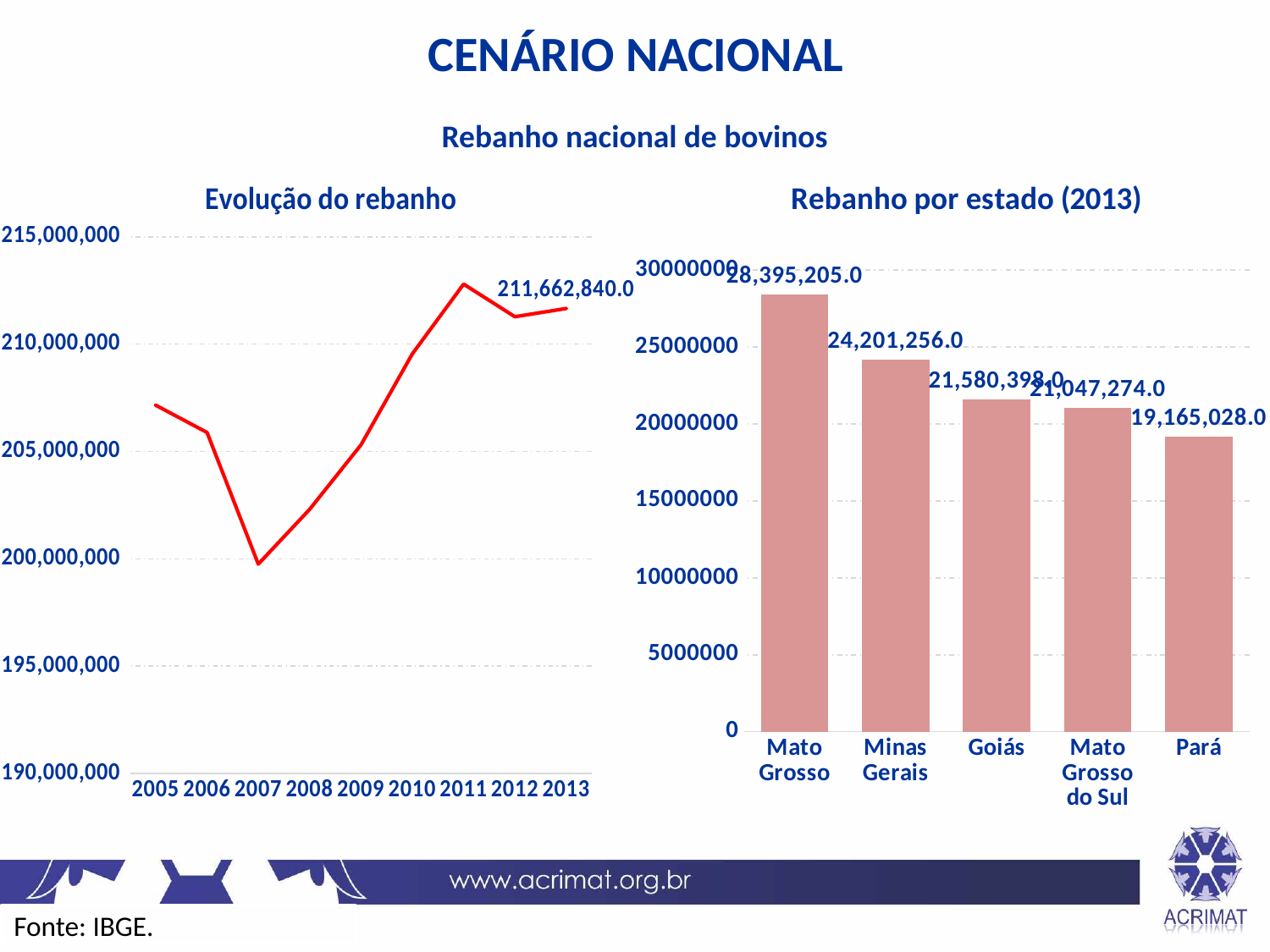
In the 'Rebanho por estado (2013)' chart, which state has the lowest value? Pará In the 'Rebanho por estado (2013)' chart, how many states are shown? 5 What kind of chart is 'Evolução do rebanho'? line chart In the 'Rebanho por estado (2013)' chart, what is the value for Pará? 19,165,028.0 In the 'Rebanho por estado (2013)' chart, what is the value for Mato Grosso? 28,395,205.0 In the 'Evolução do rebanho' chart, which year has the lowest value? 2007 In the 'Rebanho por estado (2013)' chart, which state has the highest value? Mato Grosso In the 'Evolução do rebanho' chart, how many years are plotted on the x axis? 9 In the 'Evolução do rebanho' chart, what is the value shown for 2013? 211,662,840.0 In the 'Rebanho por estado (2013)' chart, what is the difference between Mato Grosso and Minas Gerais? 4,193,949.0 In the 'Evolução do rebanho' chart, do the values rise or fall from 2007 to 2011? rise